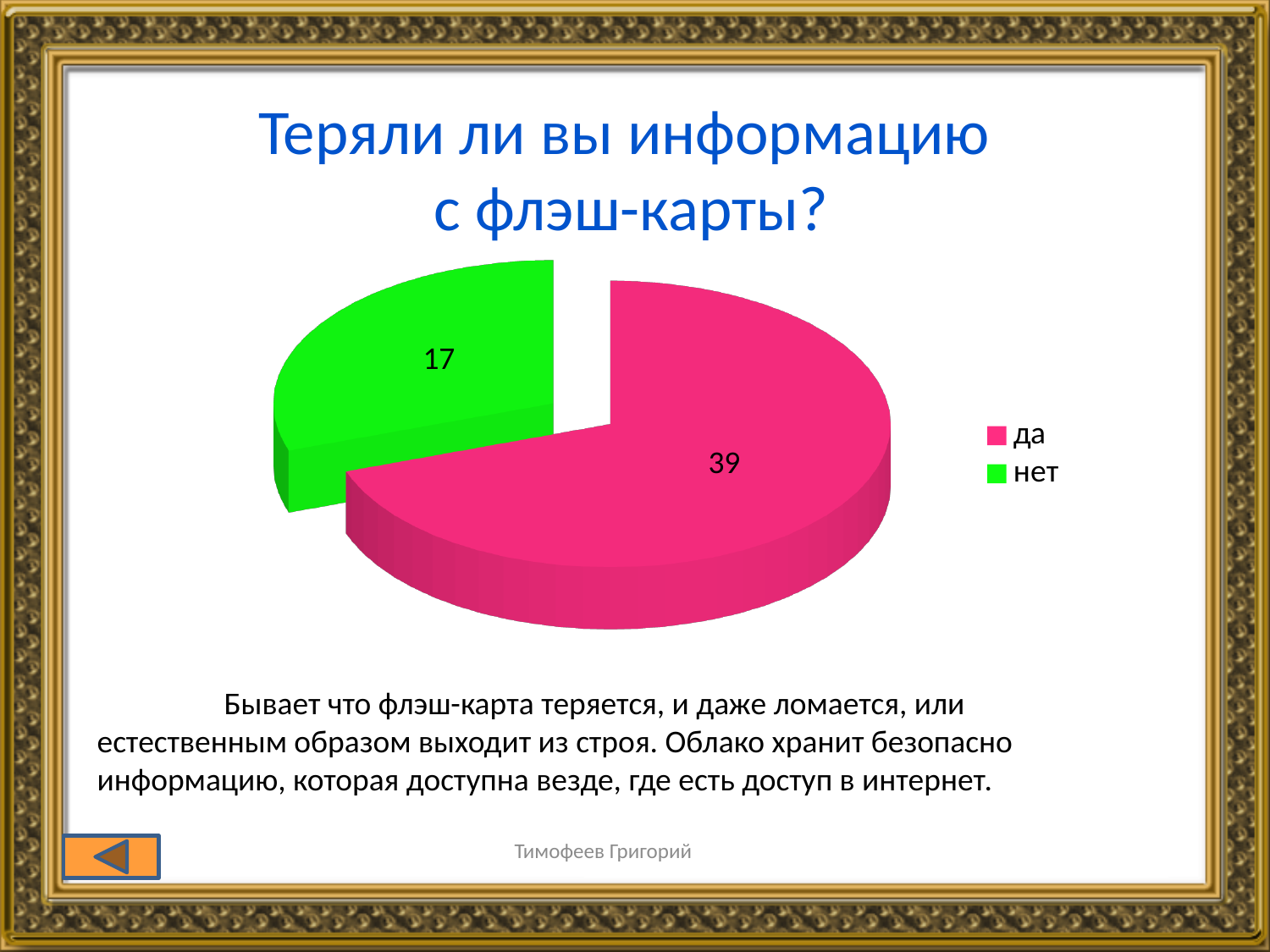
Which category has the smallest slice? нет Which category has the largest slice? да What is the total of all slices in the pie chart? 56 What is the value for "нет"? 17 What is the title of the chart? Теряли ли вы информацию с флэш-карты? How many slices does the pie chart have? 2 What colour is the slice for "нет"? green What is the difference between the values for "да" and "нет"? 22 Which is larger, the value for "да" or the value for "нет"? да What is the value for "да"? 39 What kind of chart is shown on the slide? pie chart How many entries does the legend list? 2